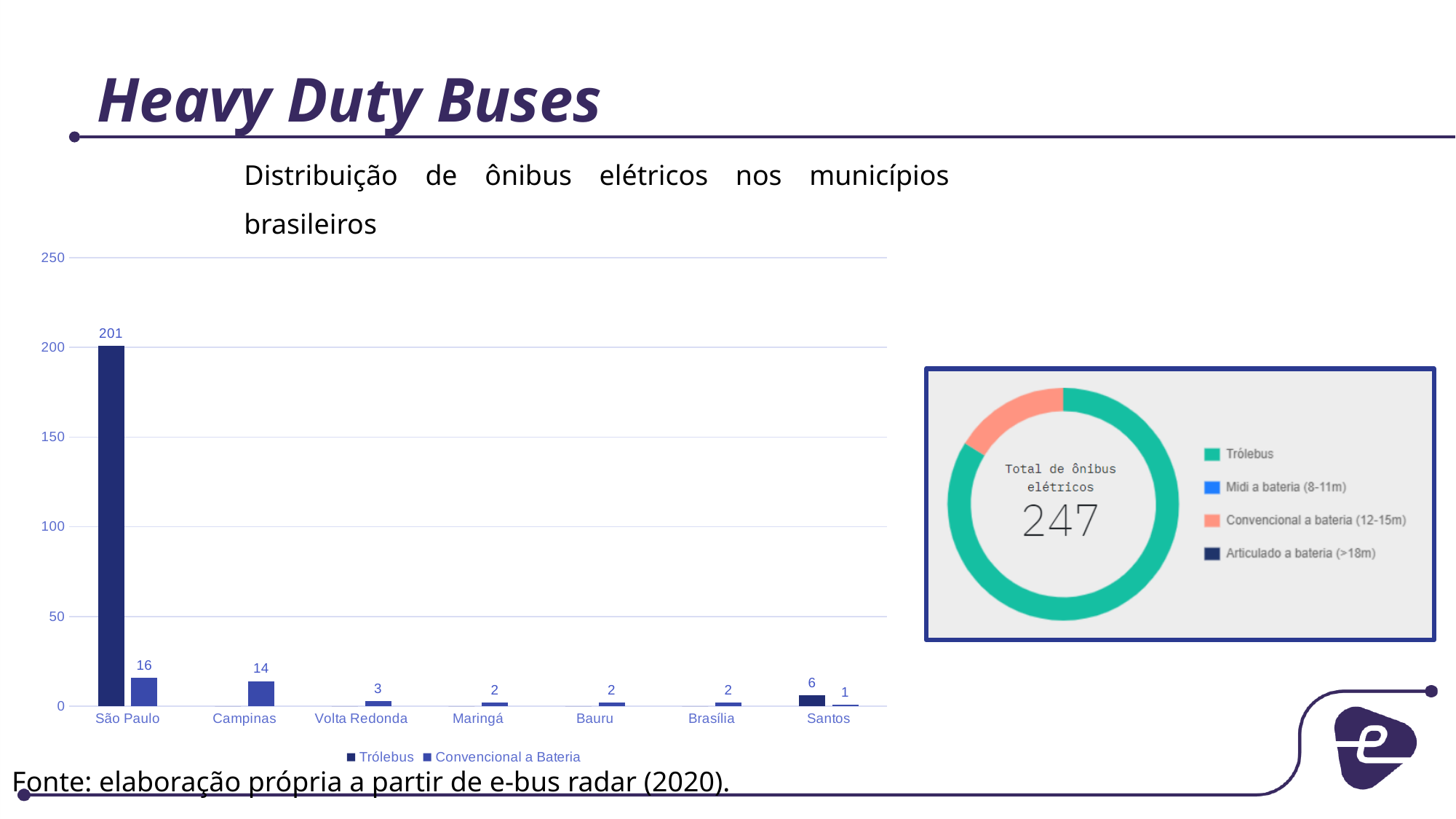
In the bar chart, which city has the lowest Convencional a Bateria value? Santos How many series does the legend of the bar chart list? 2 In the bar chart, what is the Trólebus value for São Paulo? 201 In the bar chart, is the Trólebus value for São Paulo greater or less than 150? greater What kind of chart is the chart on the right side of the slide? Donut chart In the bar chart, what is the Convencional a Bateria value for Campinas? 14 In the bar chart, what is the Trólebus value for Santos? 6 How many cities are shown on the x axis of the bar chart? 7 In the bar chart, what is the difference between the Trólebus and Convencional a Bateria values for São Paulo? 185 What total number of electric buses is shown in the centre of the donut chart? 247 In the bar chart, which is larger: the Convencional a Bateria value for Campinas or for Volta Redonda? Campinas In the bar chart, which city has the highest Convencional a Bateria value? São Paulo